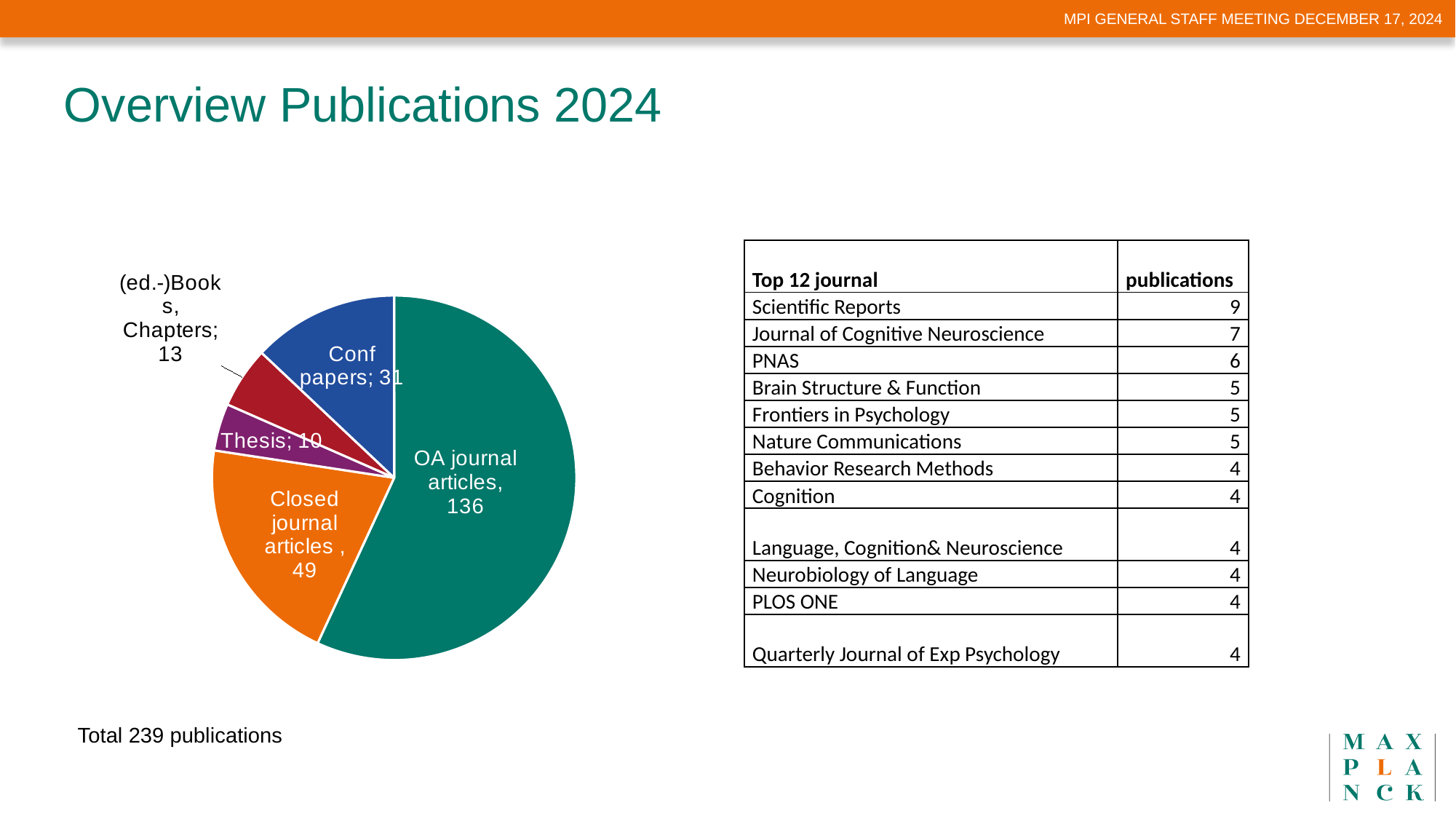
What is the total number of publications stated below the pie chart? 239 What is the value for Conf papers in the pie chart? 31 What is the value for Thesis in the pie chart? 10 Which category has the largest slice in the pie chart? OA journal articles What is the value for OA journal articles in the pie chart? 136 What is the value for (ed.-)Books, Chapters in the pie chart? 13 Which category has the smallest slice in the pie chart? Thesis Which is larger in the pie chart, Conf papers or (ed.-)Books, Chapters? Conf papers What is the value for Closed journal articles in the pie chart? 49 How many slices does the pie chart have? 5 What is the difference between OA journal articles and Closed journal articles in the pie chart? 87 What kind of chart is shown on the slide? pie chart